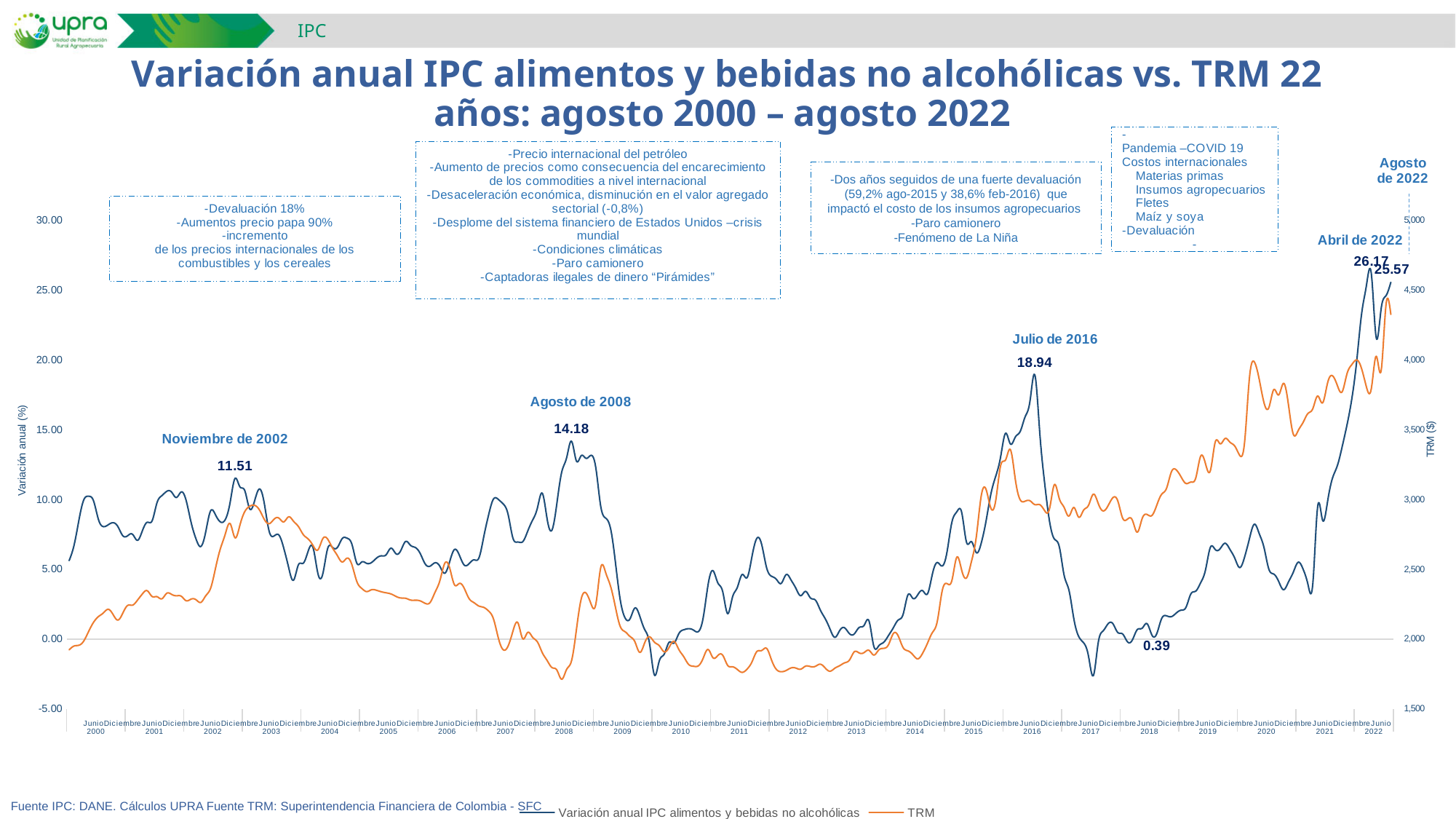
What kind of chart is shown on the slide? line chart What is the annual IPC variation labelled for Abril de 2022? 26.17 What is the annual IPC variation labelled for Agosto de 2022? 25.57 What is the annual IPC variation labelled for Agosto de 2008? 14.18 What is the difference between the labelled values for Julio de 2016 and Noviembre de 2002? 7.43 What is the annual IPC variation labelled for Julio de 2016? 18.94 Which series is drawn in orange according to the legend? TRM How many series does the legend list? 2 Which labelled value is larger: Julio de 2016 or Agosto de 2008? Julio de 2016 What is the annual IPC variation labelled for Noviembre de 2002? 11.51 Which labelled point has the highest annual IPC variation? Abril de 2022 What is the difference between the labelled values for Abril de 2022 and Agosto de 2022? 0.60